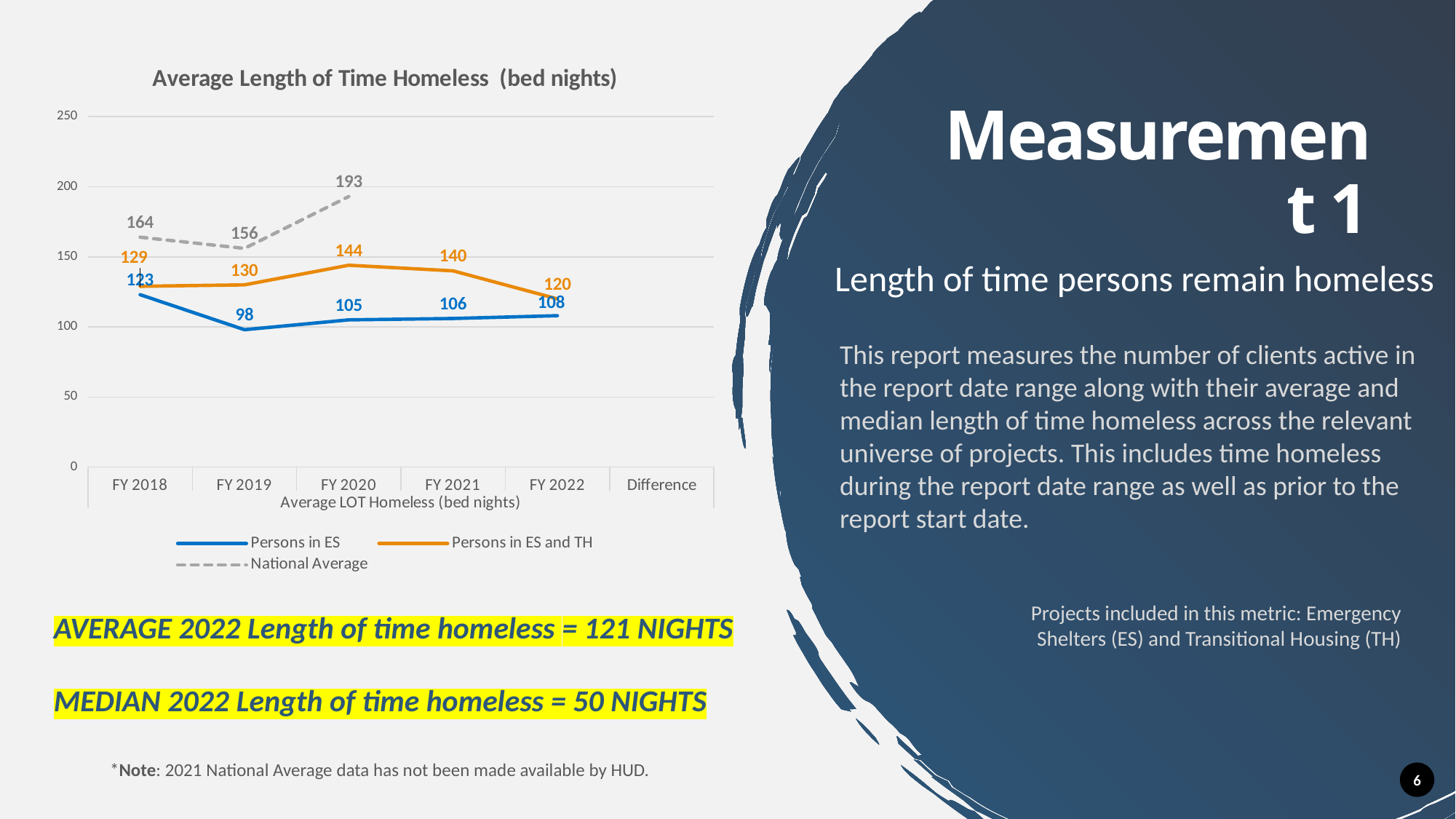
What is the value for Persons in ES and TH in FY 2020? 144 In which fiscal year is the Persons in ES value lowest? FY 2019 What type of chart is shown on the slide? line chart What is the title of the chart? Average Length of Time Homeless (bed nights) What is the difference between the National Average and Persons in ES values in FY 2018? 41 What is the value for Persons in ES in FY 2019? 98 Which is larger in FY 2022, Persons in ES or Persons in ES and TH? Persons in ES and TH In which fiscal year is the Persons in ES and TH value highest? FY 2020 How many fiscal years have data plotted for Persons in ES? 5 What is the National Average value in FY 2020? 193 Does the Persons in ES and TH series rise or fall from FY 2020 to FY 2022? fall How many series does the chart legend list? 3